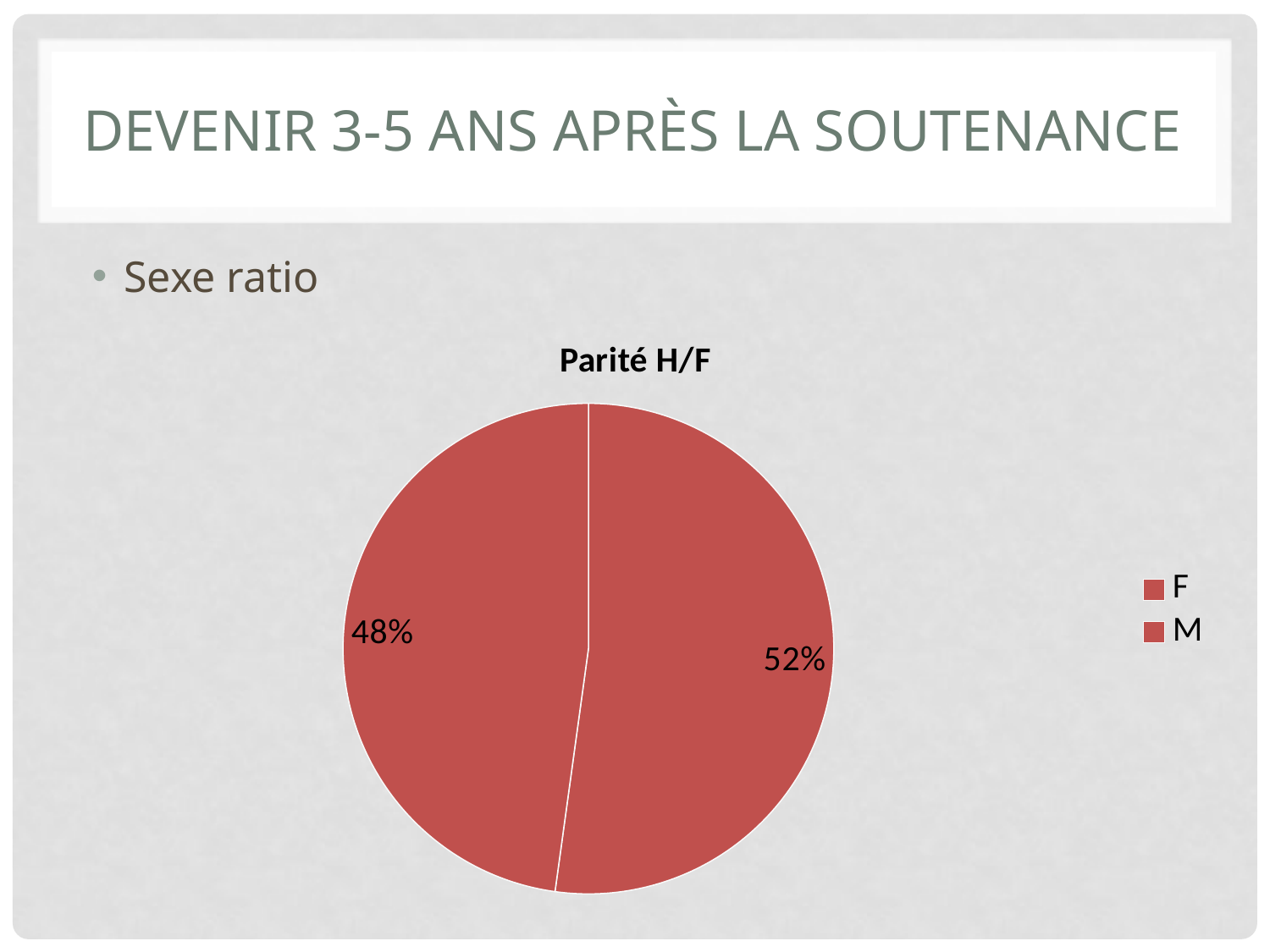
Is the value of the right-hand slice greater or less than 50%? greater How many slices does the pie chart have? 2 What is the smallest percentage shown on the pie chart? 48% What is the largest percentage shown on the pie chart? 52% What percentage is shown on the right-hand slice of the pie? 52% What are the two entries in the chart's legend? F and M What percentage is shown on the left-hand slice of the pie? 48% What is the difference in percentage points between the two slices of the pie? 4 How many entries does the legend list? 2 Which slice is larger, the one labelled 52% or the one labelled 48%? 52% What kind of chart is shown on the slide? pie chart What is the title of the chart? Parité H/F